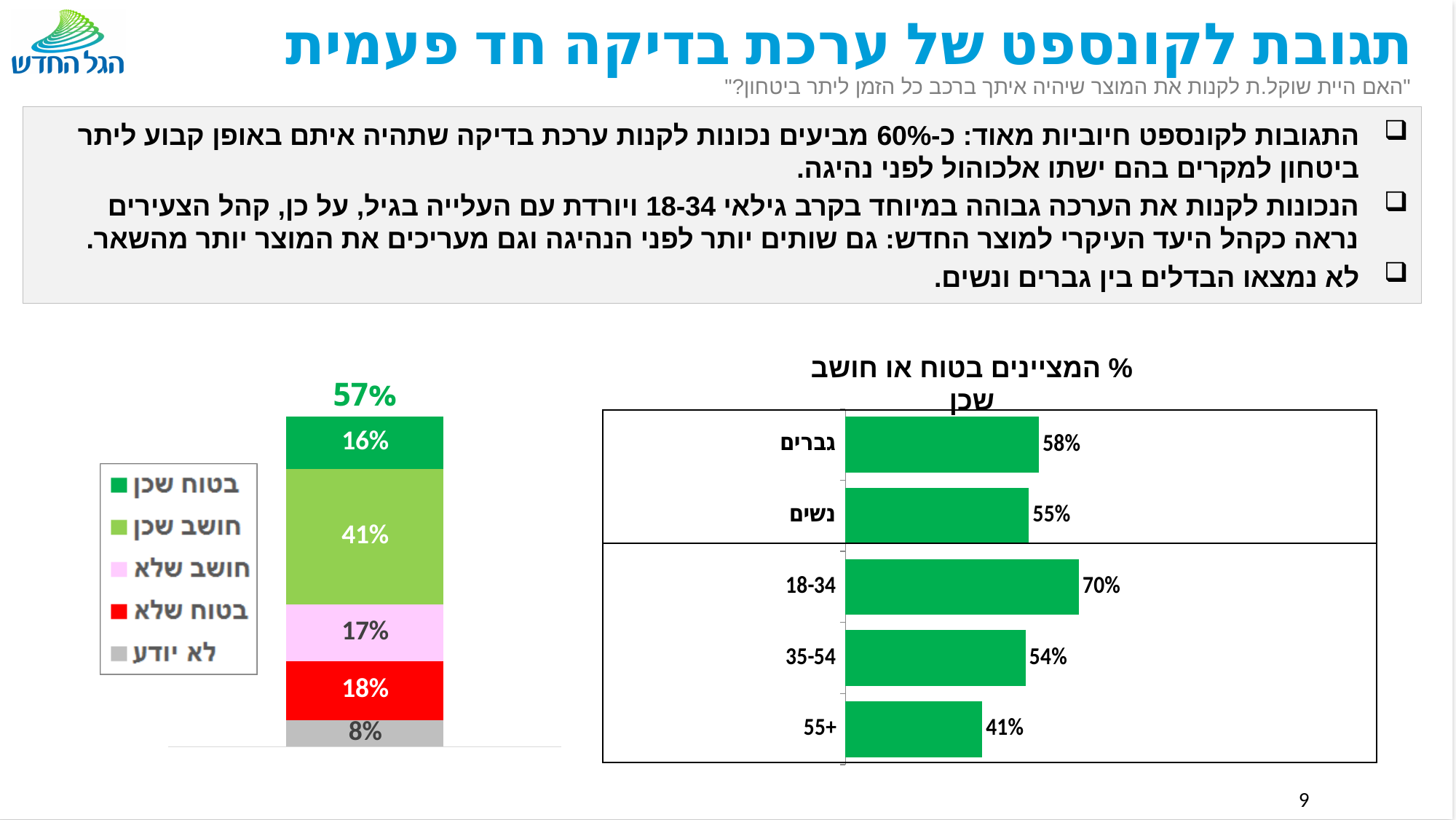
In the left-hand stacked bar chart, what is the value of the בטוח שלא (red) segment? 18% In the right-hand chart, what is the difference between the values for גברים and נשים? 3% In the right-hand chart, which category has the highest value? 18-34 In the right-hand chart, how many categories are plotted? 5 In the right-hand chart, what is the value for the 55+ age group? 41% How many entries does the legend of the left-hand stacked bar chart list? 5 In the left-hand stacked bar chart, what is the value of the חושב שכן (light green) segment? 41% In the right-hand chart, what is the value for גברים (men)? 58% In the right-hand chart, which category has the lowest value? 55+ What kind of chart is the right-hand chart? Bar chart In the right-hand chart titled "% המציינים בטוח או חושב שכן", what is the value for the 18-34 age group? 70% In the right-hand chart, what is the difference between the 18-34 and 35-54 age groups? 16%